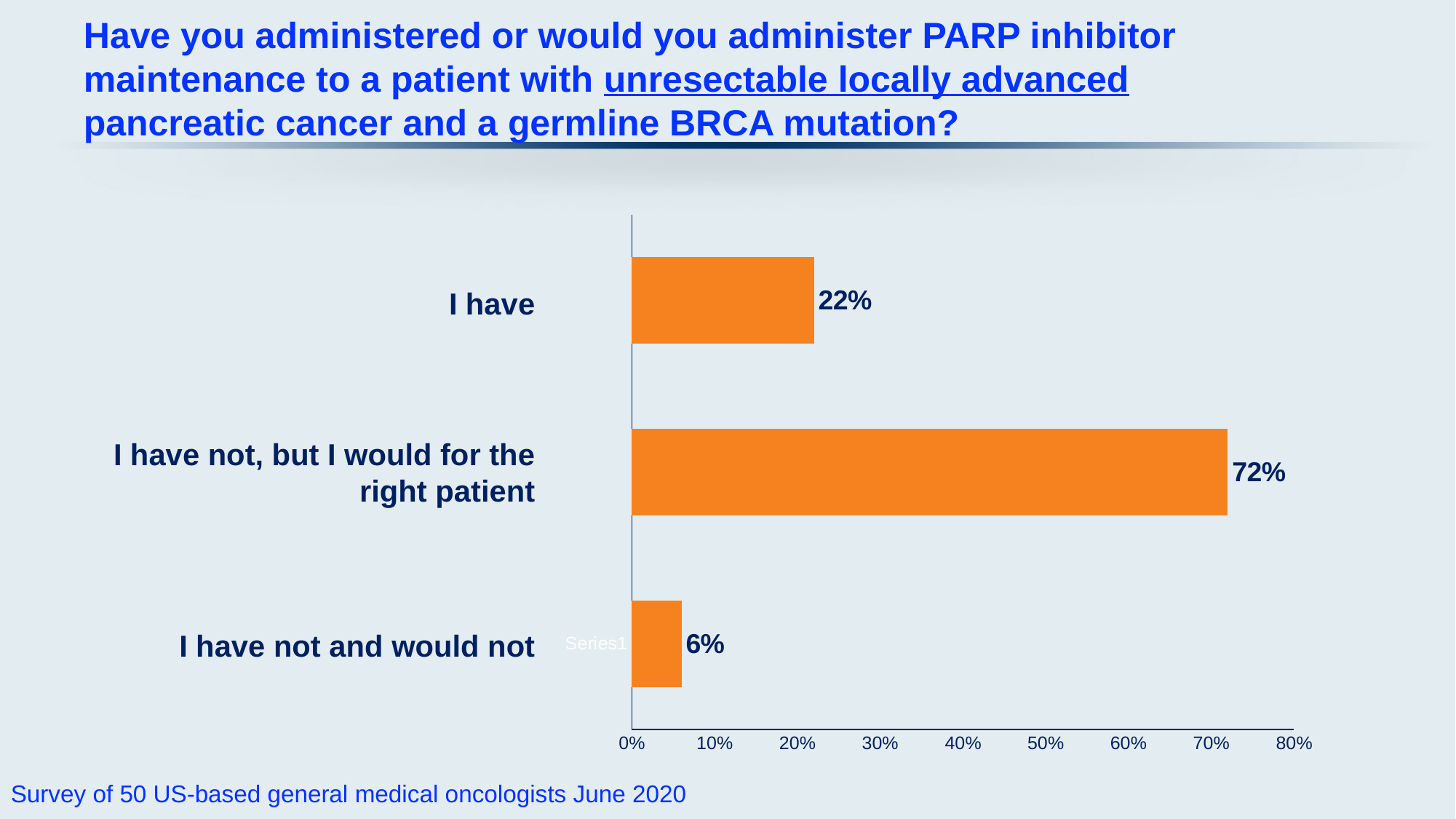
What percentage of respondents answered "I have not and would not"? 6% Which response category has the highest percentage? I have not, but I would for the right patient What percentage of respondents answered "I have not, but I would for the right patient"? 72% What percentage of respondents answered "I have"? 22% What type of chart is shown on the slide? Bar chart Which is larger: the value for "I have" or the value for "I have not and would not"? I have Is the value for "I have not, but I would for the right patient" greater or less than 50%? greater What is the maximum value shown on the horizontal axis? 80% What is the difference in percentage points between "I have" and "I have not and would not"? 16 percentage points What is the difference in percentage points between "I have not, but I would for the right patient" and "I have"? 50 percentage points How many response categories are shown in the chart? 3 Which response category has the lowest percentage? I have not and would not